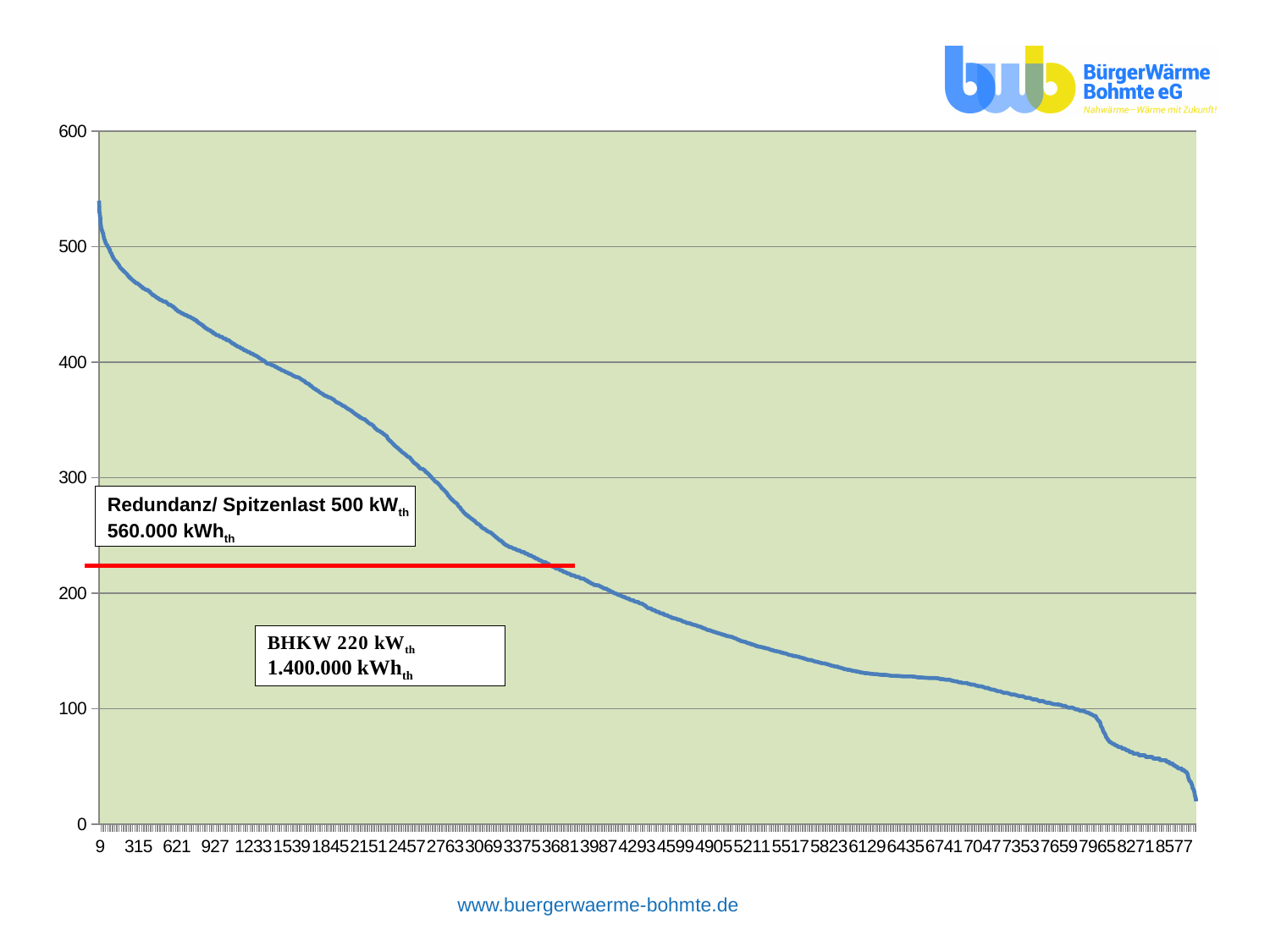
What is the highest value shown on the y axis of the chart? 600 Is the value of the curve at x = 6741 greater or less than 200? less Is the value at the right end of the curve (x = 8577) greater or less than 100? less Is the value of the curve at x = 2151 greater or less than 300? greater What kind of chart is shown on the slide? line chart What capacity is given in the annotation box labelled BHKW on the chart? 220 kWth Do the plotted values rise or fall as you move from left to right along the x axis? fall